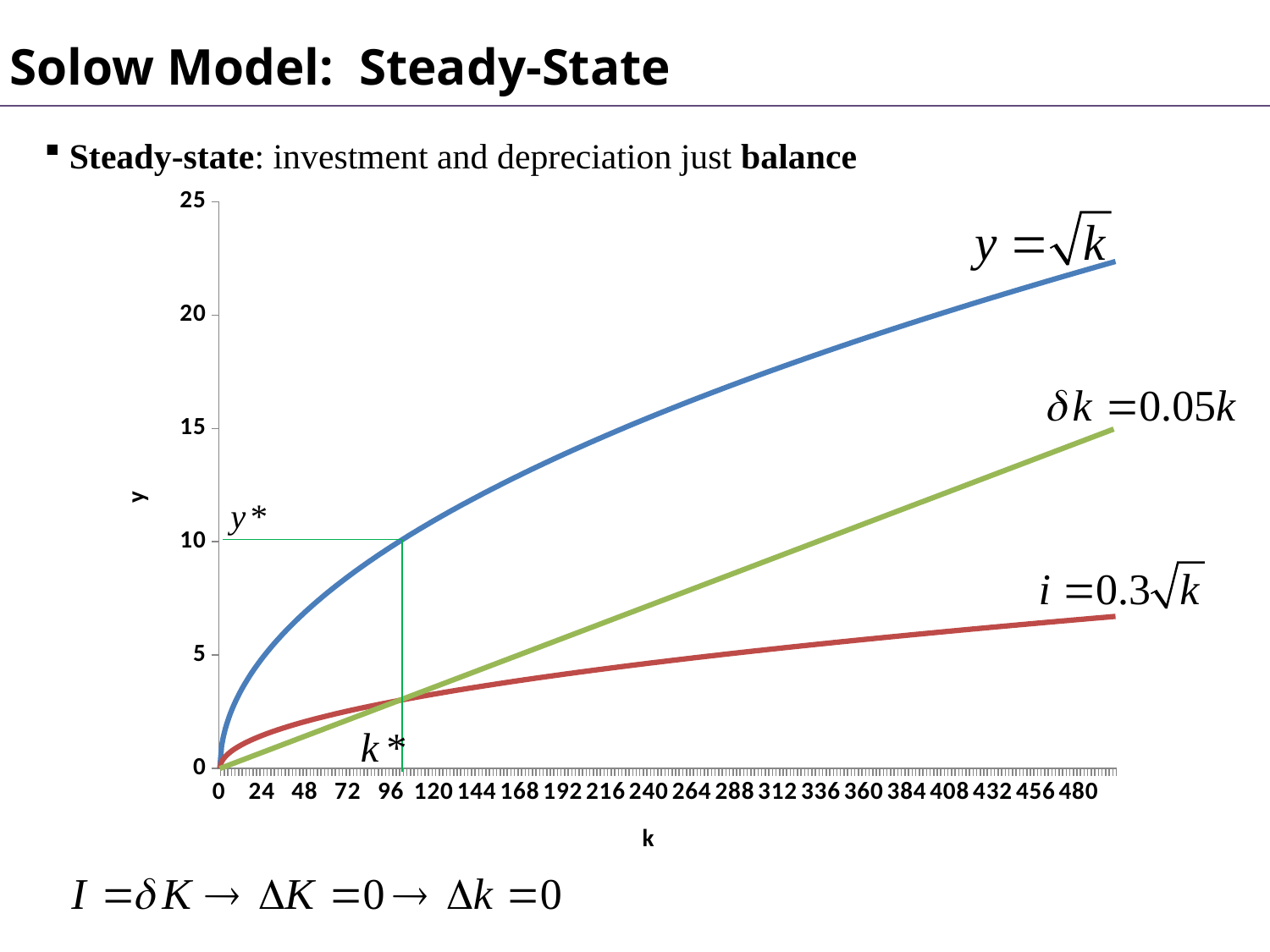
What is the label on the x axis of the chart? k At k = 480, is the value of the i = 0.3√k curve greater or less than 10? less What value on the y axis does the horizontal line marking y* reach? 10 At k = 480, is the value of the δk = 0.05k line greater or less than 10? greater Which curve is lowest at k = 480? i = 0.3√k At k = 240, which is larger: the δk = 0.05k line or the i = 0.3√k curve? δk = 0.05k How many curves are plotted on the chart? 3 What kind of chart is shown on the slide? line chart Does the y = √k curve rise or fall as k increases? rise At k = 480, is the value of the y = √k curve greater or less than 20? greater Which curve is highest at k = 480? y = √k What is the label on the y axis of the chart? y